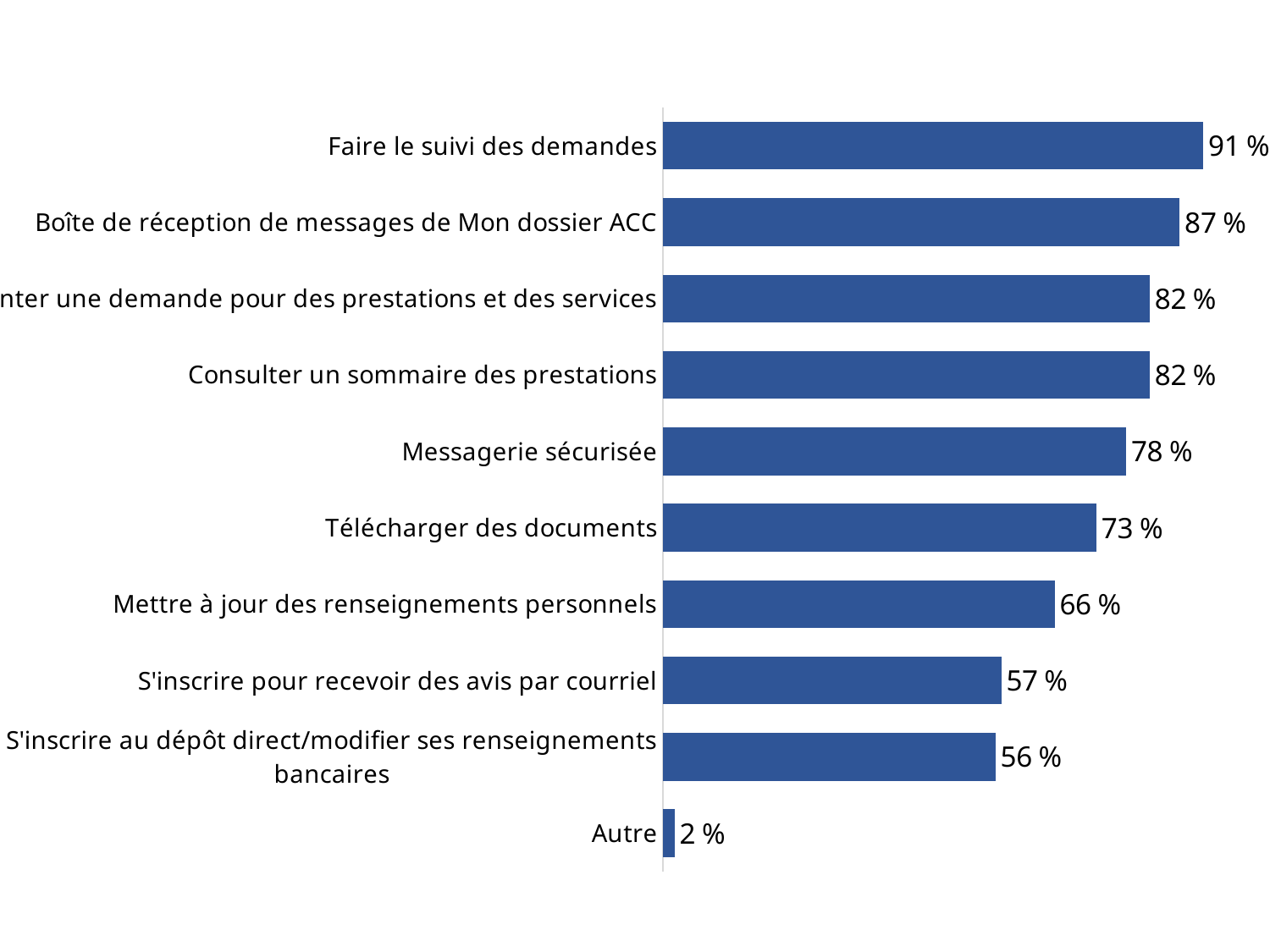
What is the value for "S'inscrire pour recevoir des avis par courriel"? 57 % What is the value for "Messagerie sécurisée"? 78 % What is the value for "Faire le suivi des demandes"? 91 % What kind of chart is shown on the slide? Bar chart Which category has the highest value? Faire le suivi des demandes What is the value for "Télécharger des documents"? 73 % What is the difference between the values for "Mettre à jour des renseignements personnels" and "Autre"? 64 % What is the difference between the values for "Faire le suivi des demandes" and "Boîte de réception de messages de Mon dossier ACC"? 4 % Which category has the lowest value? Autre Which is larger, the value for "Télécharger des documents" or the value for "Mettre à jour des renseignements personnels"? Télécharger des documents How many categories are shown in the chart? 10 What is the value for "S'inscrire au dépôt direct/modifier ses renseignements bancaires"? 56 %